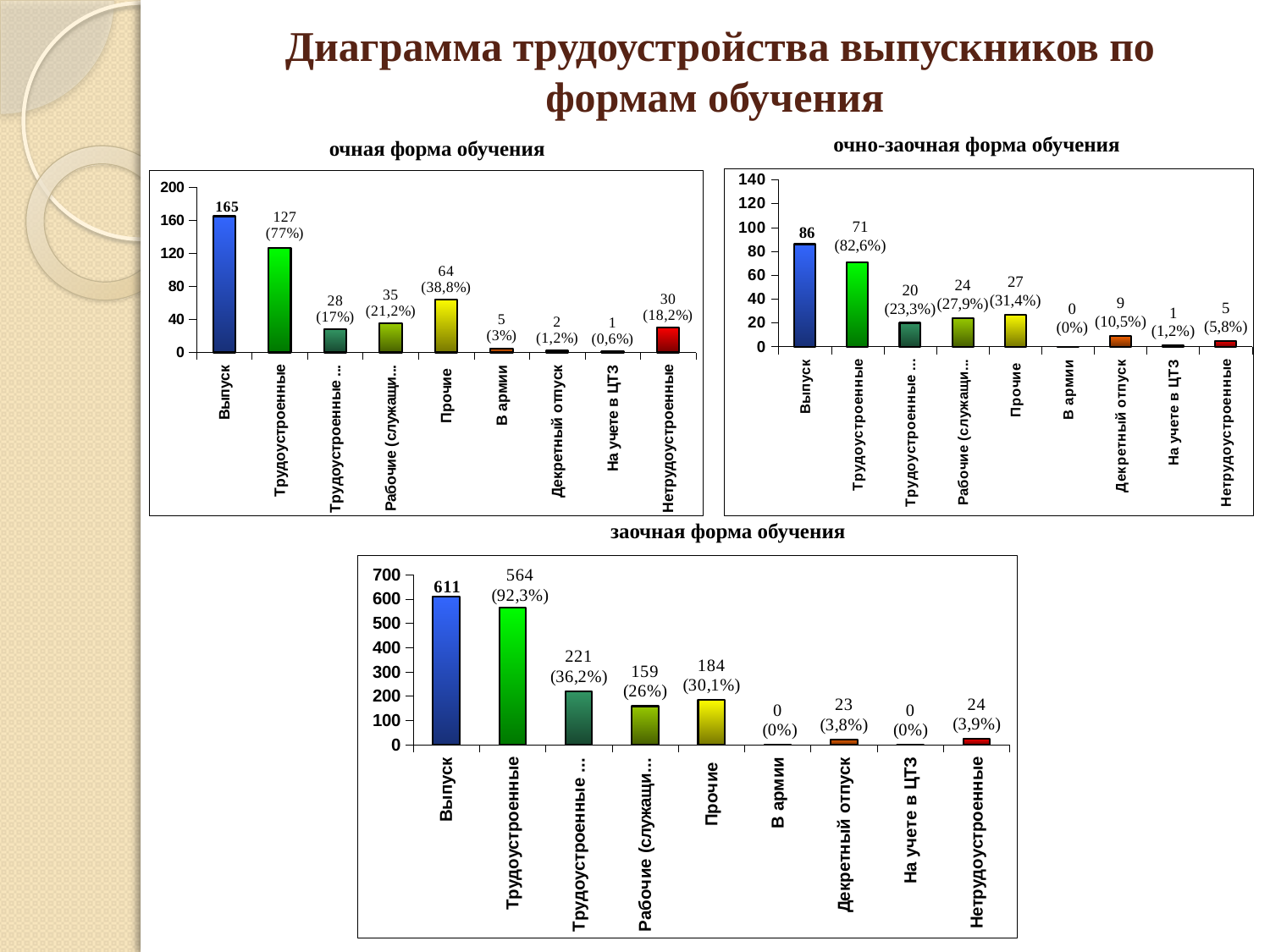
In the chart titled "заочная форма обучения", is the value for Трудоустроенные greater or less than 500? greater In the chart titled "заочная форма обучения", which category has the highest value? Выпуск How many categories are shown on the x axis of the chart titled "очно-заочная форма обучения"? 9 In the chart titled "заочная форма обучения", what value is shown for Декретный отпуск? 23 (3,8%) In the chart titled "очно-заочная форма обучения", what value is shown for Трудоустроенные? 71 (82,6%) In the chart titled "очная форма обучения", what is the difference between the values for Выпуск and Трудоустроенные? 38 What kind of chart is the chart titled "заочная форма обучения"? bar chart In the chart titled "очная форма обучения", which category has the lowest value? На учете в ЦТЗ How many charts are shown on the slide? 3 In the chart titled "очная форма обучения", what value is shown for Нетрудоустроенные? 30 (18,2%) In the chart titled "очно-заочная форма обучения", which is larger: the value for Прочие or the value for Декретный отпуск? Прочие In the chart titled "очная форма обучения", what is the value for Выпуск? 165